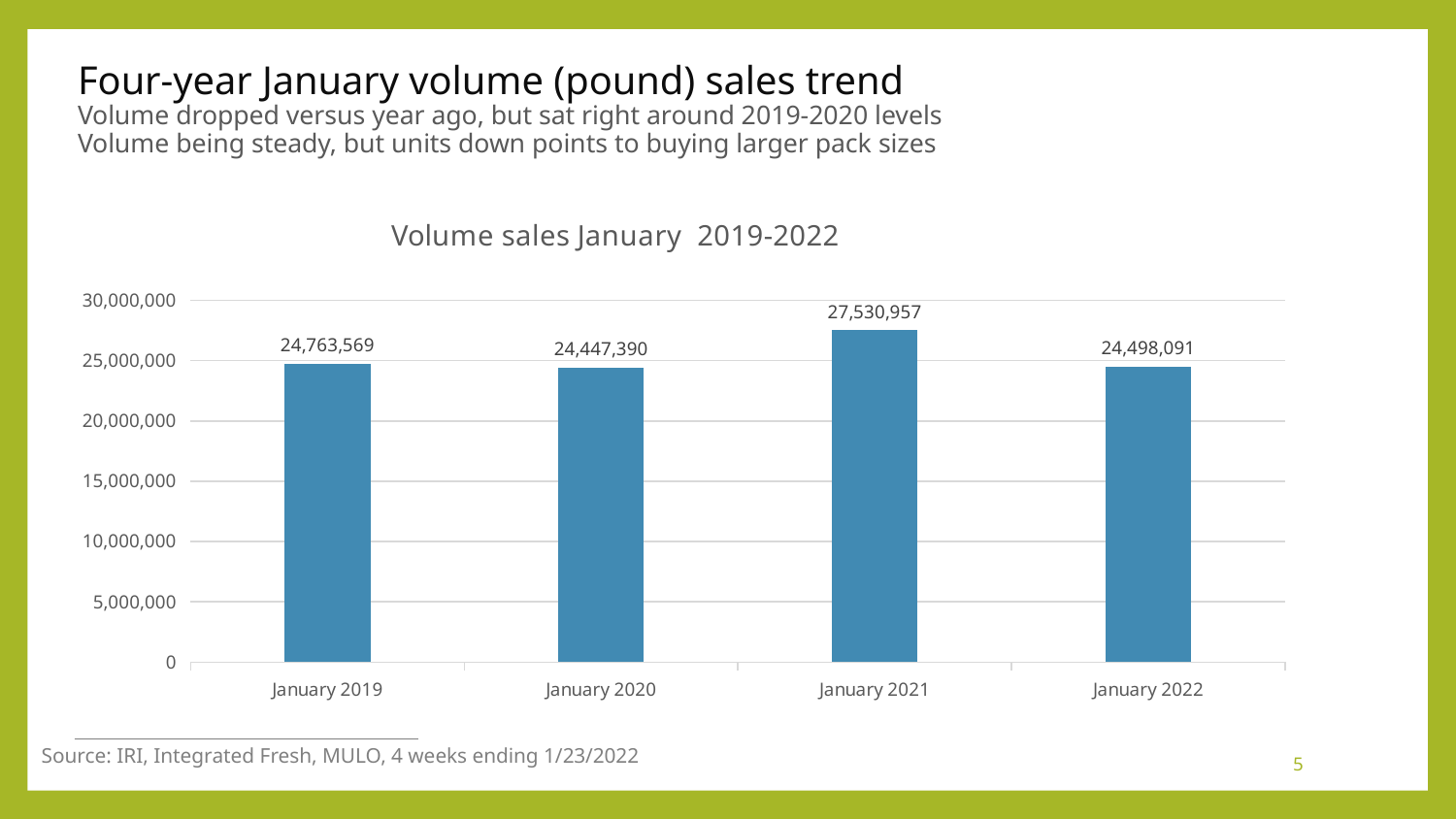
What is the volume sales value for January 2021? 27,530,957 What is the title of the chart? Volume sales January 2019-2022 What is the volume sales value for January 2022? 24,498,091 Is the value for January 2021 greater or less than 25,000,000? greater How many categories are shown on the x axis? 4 Which January has the lowest volume sales? January 2020 What is the difference in volume sales between January 2019 and January 2020? 316,179 What kind of chart is shown on the slide? Bar chart Which is larger, the volume sales for January 2021 or January 2019? January 2021 What is the difference in volume sales between January 2021 and January 2022? 3,032,866 What is the volume sales value for January 2019? 24,763,569 Which January has the highest volume sales? January 2021